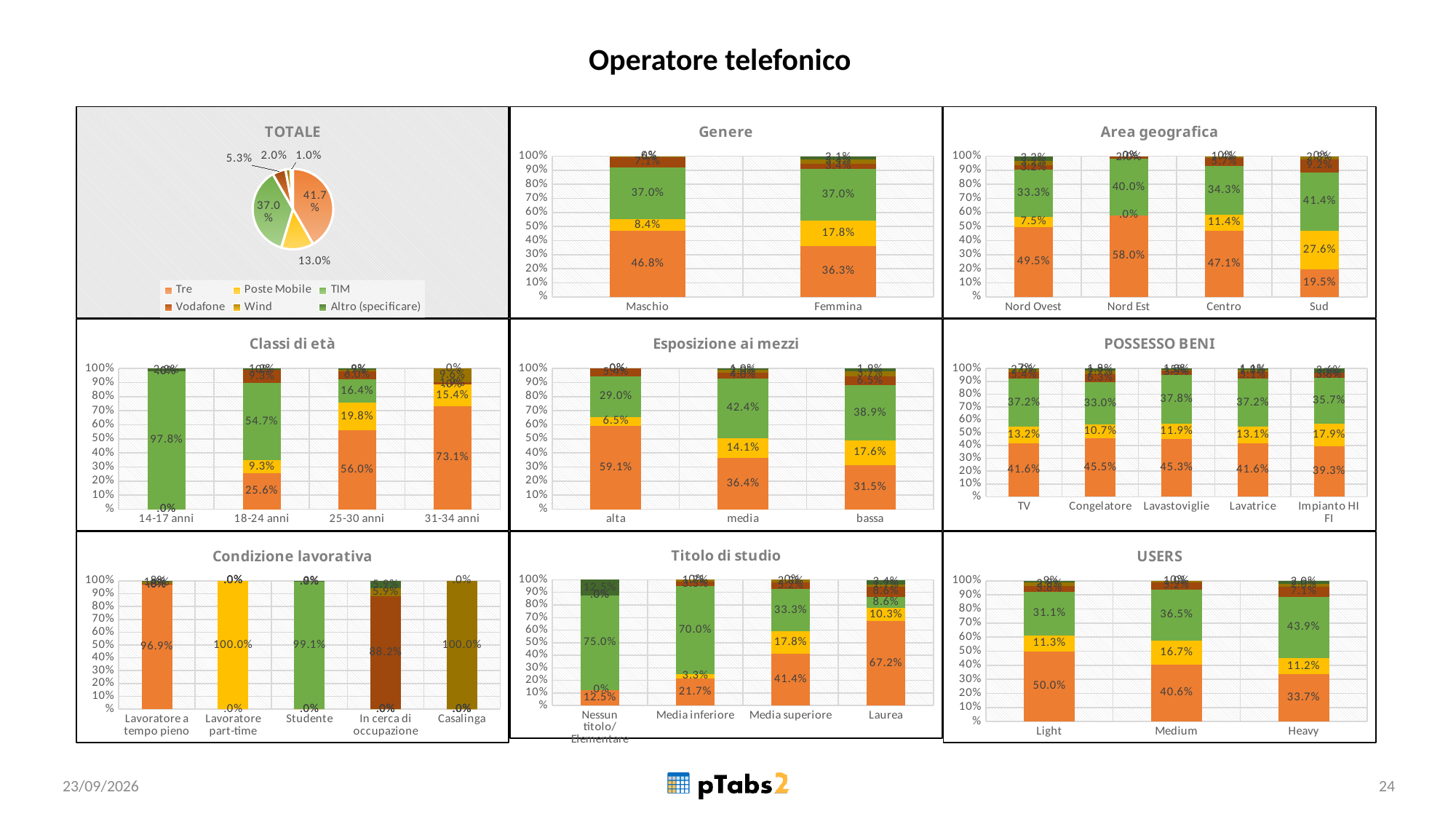
In the Genere chart, what is the difference between the Poste Mobile values for Femmina and Maschio? 9.4% How many entries does the legend of the TOTALE chart list? 6 In the Area geografica chart, what is the TIM value for Sud? 41.4% In the Genere chart, what is the Tre value for Maschio? 46.8% In the TOTALE pie chart, what share does Tre have? 41.7% In the Titolo di studio chart, what is the Tre value for Laurea? 67.2% In the TOTALE pie chart, which operator has the smallest slice? Altro (specificare) How many categories are shown on the x axis of the POSSESSO BENI chart? 5 In the Area geografica chart, which area has the highest Tre value? Nord Est What kind of chart is the USERS chart? Stacked bar chart In the Classi di età chart, what is the TIM value for 14-17 anni? 97.8% In the Esposizione ai mezzi chart, which is larger for 'media': the Tre value or the TIM value? TIM